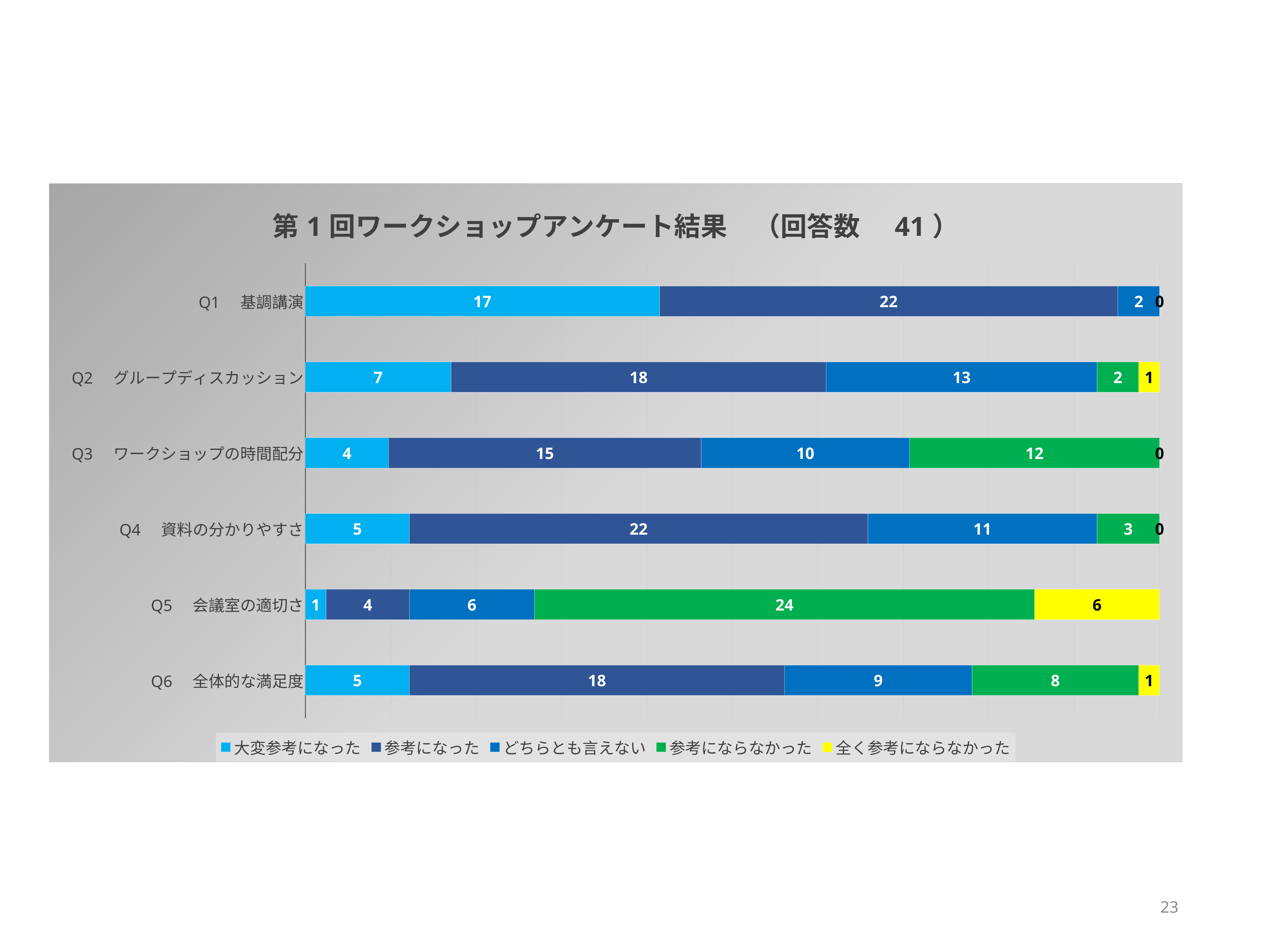
Which is larger: the 参考にならなかった value for Q3 ワークショップの時間配分 or for Q6 全体的な満足度? Q3 ワークショップの時間配分 What is the value of どちらとも言えない for Q2 グループディスカッション? 13 What is the value of 全く参考にならなかった for Q6 全体的な満足度? 1 What is the difference between the 参考になった values for Q4 資料の分かりやすさ and Q3 ワークショップの時間配分? 7 How many categories (questions) are plotted on the chart? 6 What is the value of 参考にならなかった for Q5 会議室の適切さ? 24 Which category has the highest value for 大変参考になった? Q1 基調講演 Which category has the lowest value for 大変参考になった? Q5 会議室の適切さ How many series does the legend list? 5 What is the total of the stacked bar for Q2 グループディスカッション? 41 What type of chart is shown on the slide? Stacked bar chart What is the value of 大変参考になった for Q1 基調講演? 17